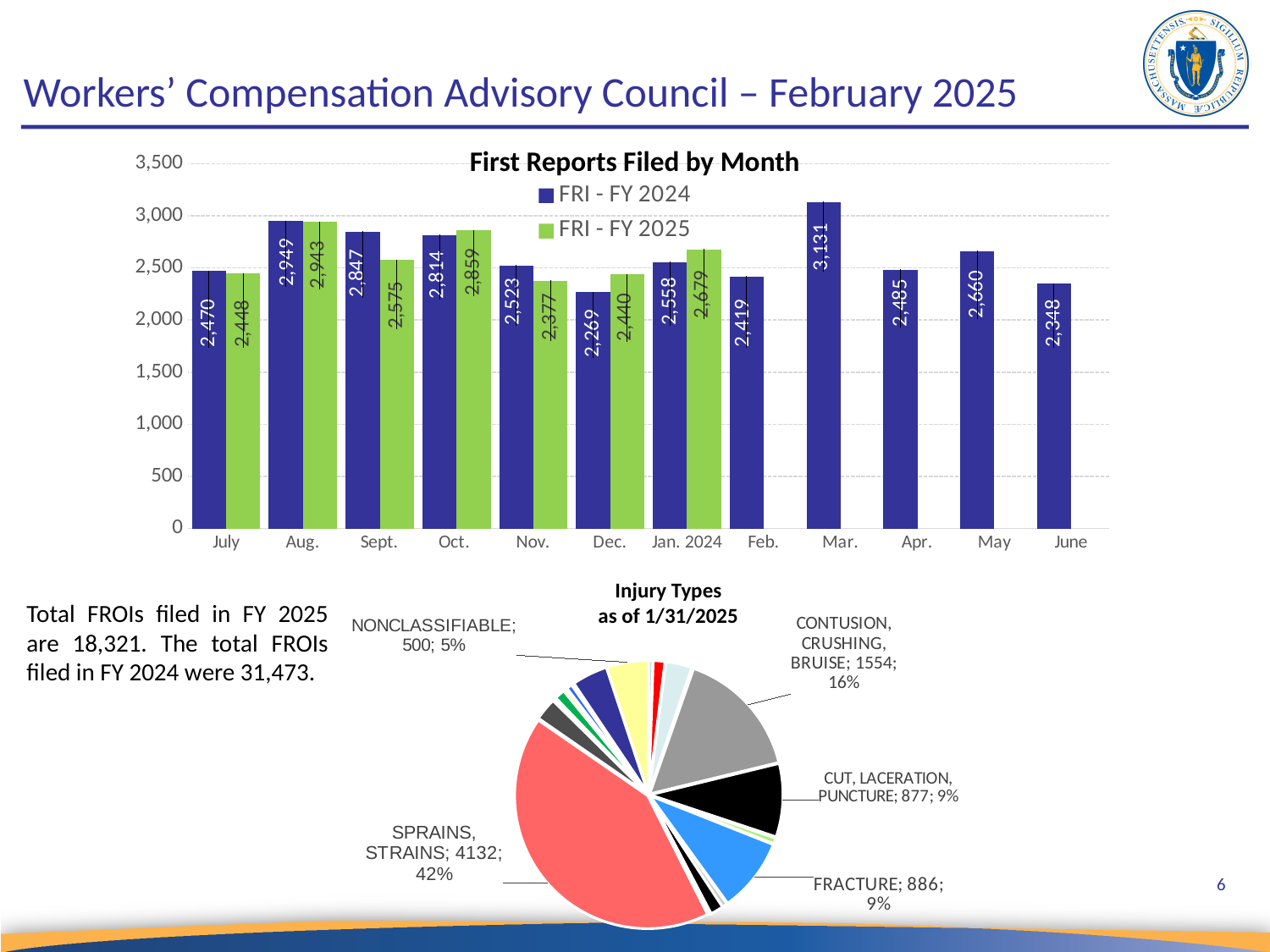
In the 'Injury Types as of 1/31/2025' pie chart, what share is SPRAINS, STRAINS? 42% In the 'First Reports Filed by Month' chart, what is the FRI - FY 2024 value for March? 3,131 In the 'First Reports Filed by Month' chart, which is larger for October: FRI - FY 2024 or FRI - FY 2025? FRI - FY 2025 In the 'First Reports Filed by Month' chart, how many months are shown on the x axis? 12 In the 'Injury Types as of 1/31/2025' pie chart, what is the value for CONTUSION, CRUSHING, BRUISE? 1554 What kind of chart is 'Injury Types as of 1/31/2025'? Pie chart In the 'First Reports Filed by Month' chart, which month has the lowest FRI - FY 2025 value? Nov. In the 'First Reports Filed by Month' chart, how many series does the legend list? 2 In the 'First Reports Filed by Month' chart, what is the FRI - FY 2024 value for June? 2,348 In the 'First Reports Filed by Month' chart, which month has the highest FRI - FY 2024 value? Mar. In the 'First Reports Filed by Month' chart, what is the FRI - FY 2025 value for December? 2,440 In the 'First Reports Filed by Month' chart, what is the difference between the FRI - FY 2024 and FRI - FY 2025 values for September? 272